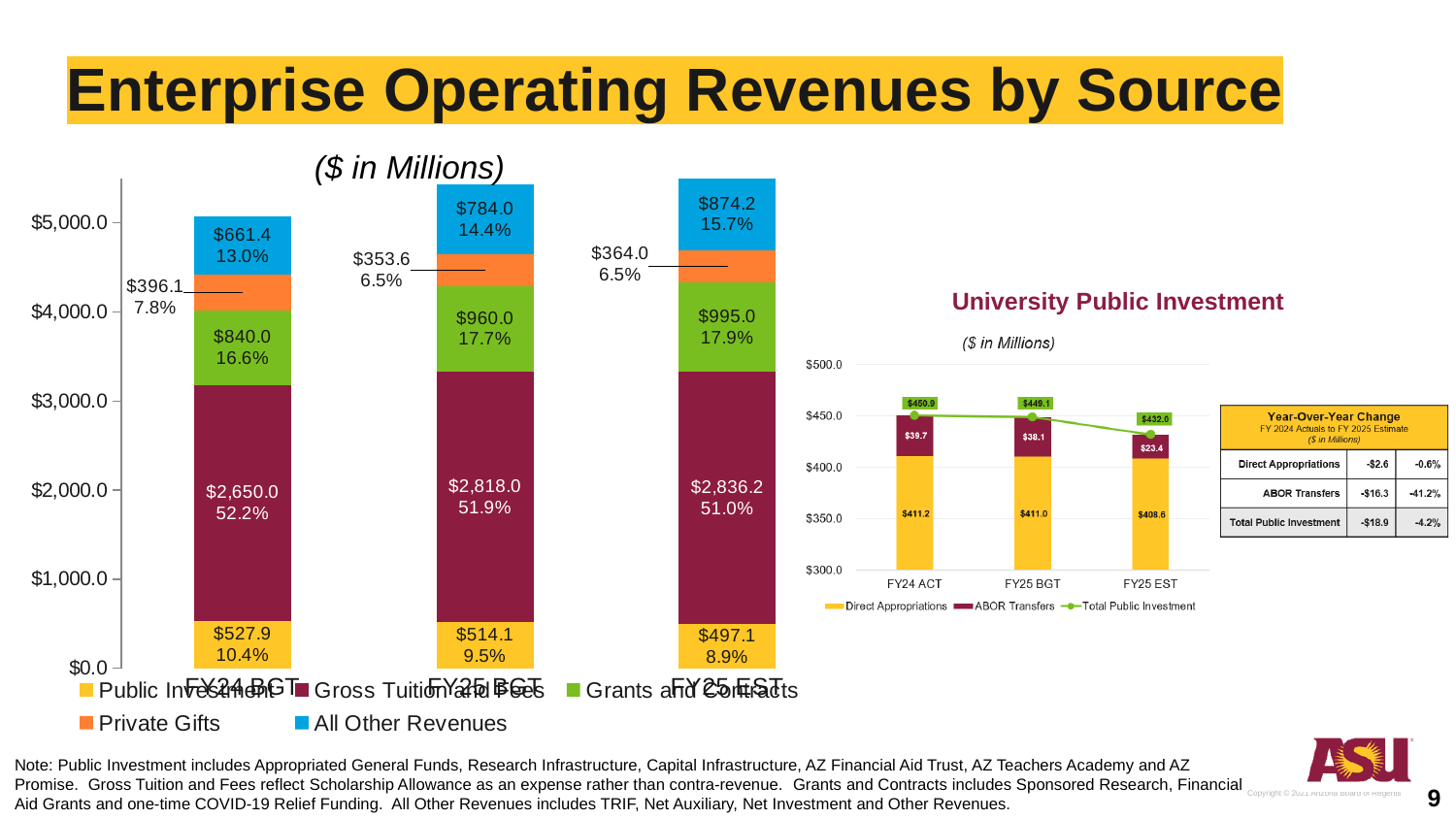
In the Enterprise Operating Revenues by Source chart, what percentage share does Grants and Contracts have in FY25 BGT? 17.7% In the Enterprise Operating Revenues by Source chart, what is the total of the FY25 BGT stacked bar? $5,429.7 In the University Public Investment chart, which period has the lowest Total Public Investment? FY25 EST In the Enterprise Operating Revenues by Source chart, what is the value for Gross Tuition and Fees in FY25 EST? $2,836.2 In the Enterprise Operating Revenues by Source chart, which revenue source is the largest in FY24 BGT? Gross Tuition and Fees In the Enterprise Operating Revenues by Source chart, how many series does the legend list? 5 In the Enterprise Operating Revenues by Source chart, what is the value for All Other Revenues in FY24 BGT? $661.4 In the Enterprise Operating Revenues by Source chart, what is the difference between Public Investment in FY24 BGT and FY25 EST? $30.8 In the University Public Investment chart, what is the difference in ABOR Transfers between FY24 ACT and FY25 EST? $16.3 In the Enterprise Operating Revenues by Source chart, which revenue source is the smallest in FY25 EST? Private Gifts In the University Public Investment chart, what is the value for Direct Appropriations in FY25 EST? $408.6 In the Enterprise Operating Revenues by Source chart, does Public Investment rise or fall from FY24 BGT to FY25 EST? fall